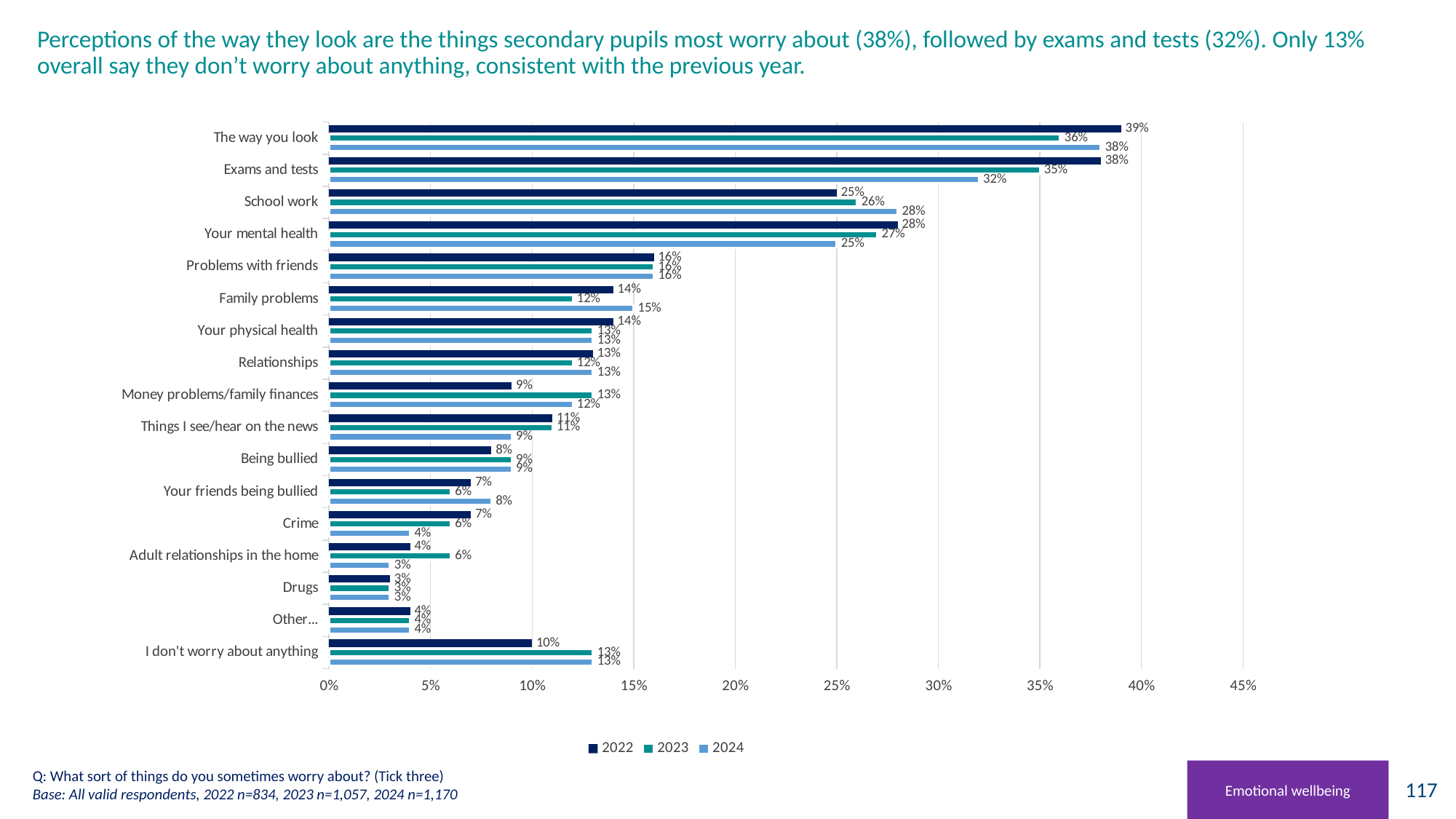
Which category has the highest value for 2024? The way you look Did the value for 'Crime' rise or fall from 2022 to 2024? Fall What is the difference between the 2022 and 2024 values for 'Exams and tests'? 6 percentage points How many categories are shown on the chart? 17 Which year is represented by the darkest bars in the legend? 2022 What was the 2022 value for 'Exams and tests'? 38% How many series does the legend list? 3 What percentage said 'I don't worry about anything' in 2022? 10% What kind of chart is shown on the slide? Bar chart Which is larger for 'School work': the 2022 value or the 2024 value? 2024 Which category has the lowest value for 2024? Adult relationships in the home and Drugs (both 3%) What percentage of pupils in 2024 said they worry about the way they look? 38%